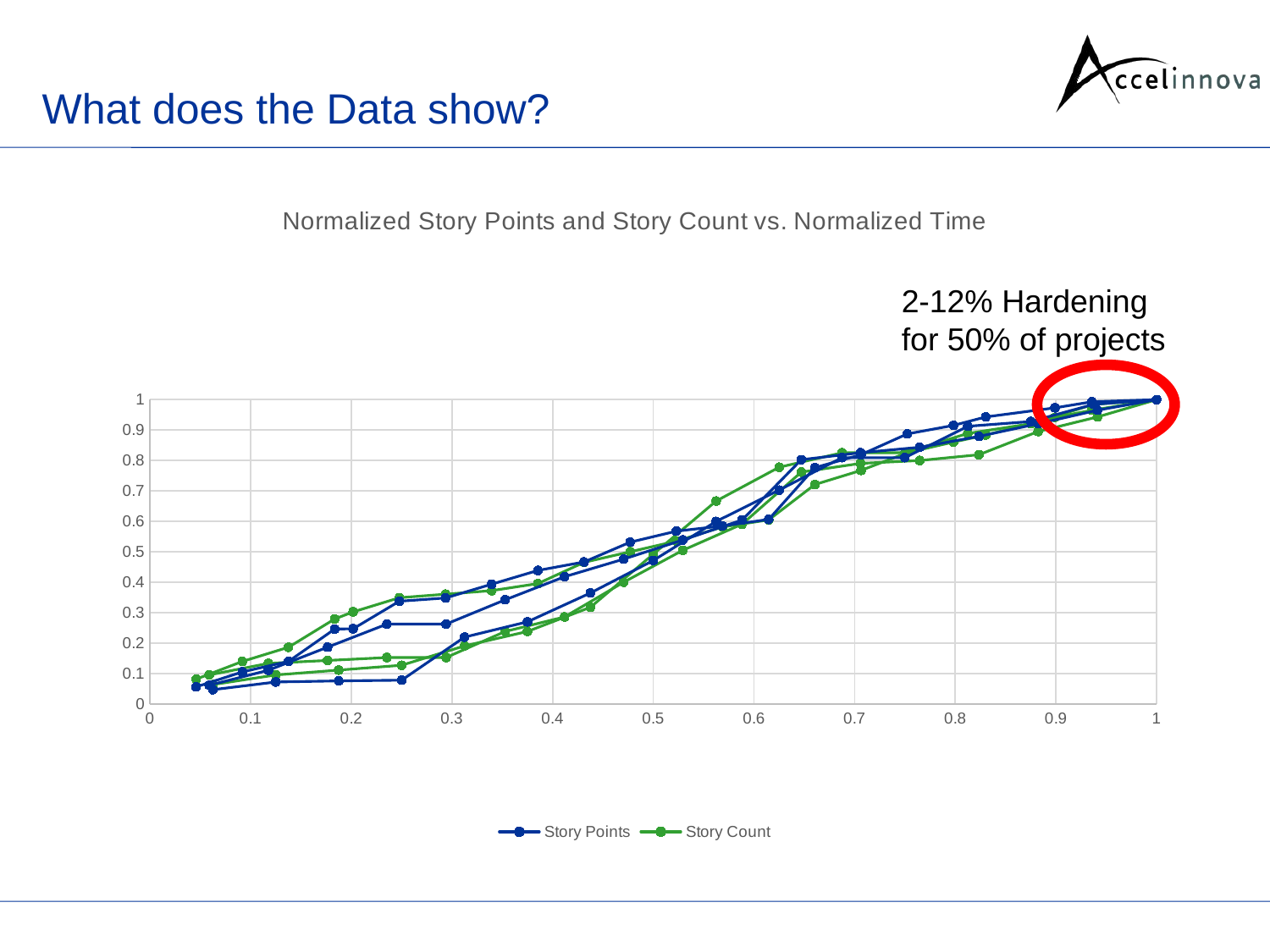
What is the lowest value shown on the y axis of the chart? 0 Which two series are listed in the chart legend? Story Points and Story Count Do the plotted values rise or fall as normalized time increases from 0 to 1? Rise How many series does the chart legend list? 2 At a normalized time of 0.8, are the plotted values greater or less than 0.7? greater What value do all the lines reach at a normalized time of 1? 1 At a normalized time of 0.3, are the plotted values greater or less than 0.5? less What is the title of the chart? Normalized Story Points and Story Count vs. Normalized Time What is the highest value shown on the y axis of the chart? 1 At a normalized time of 0.1, are the plotted values greater or less than 0.3? less What kind of chart is shown on the slide? Line chart